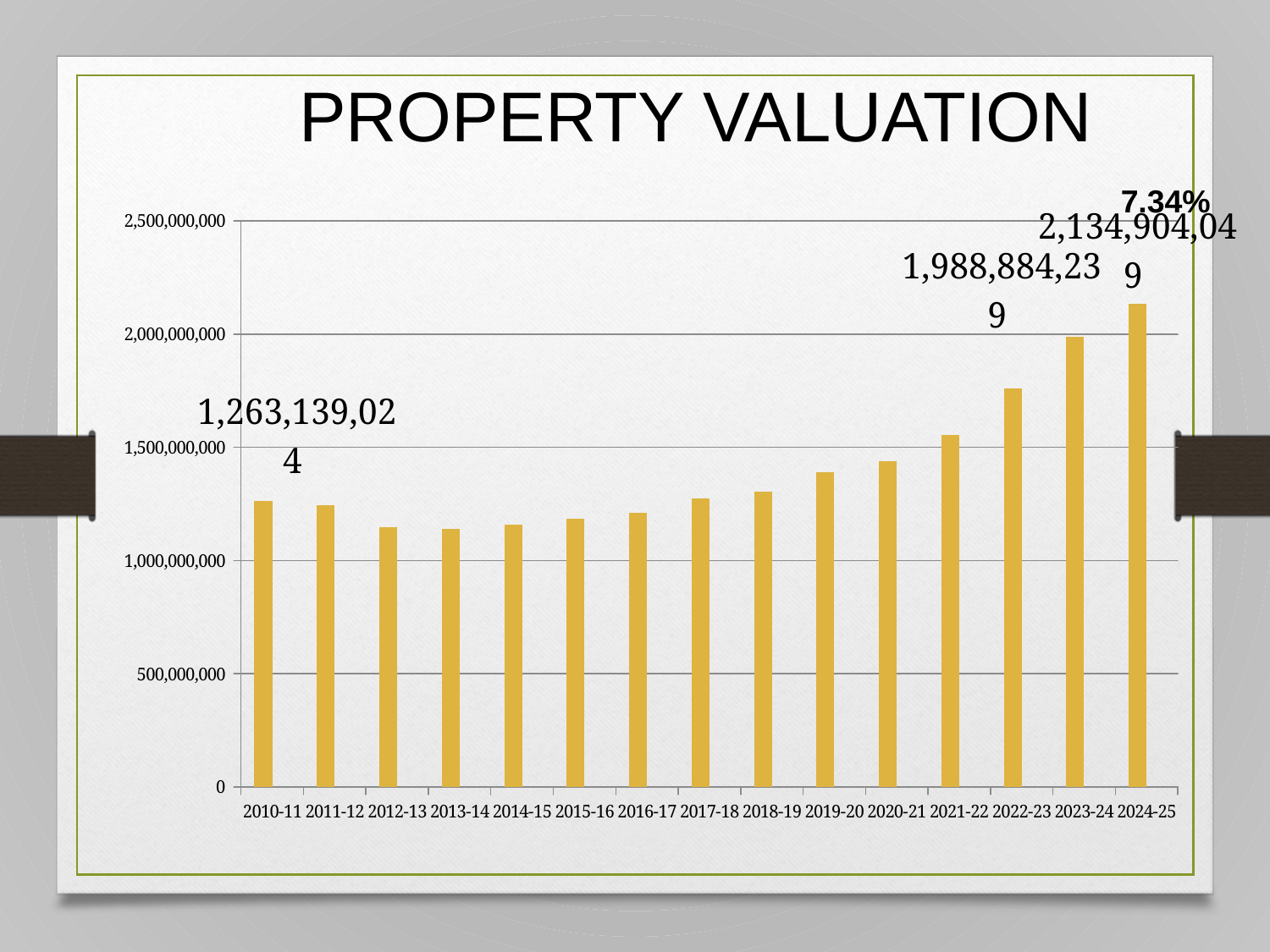
What is the property valuation for 2023-24? 1,988,884,239 What is the difference between the property valuation for 2024-25 and 2023-24? 146,019,810 How many years are shown on the x axis of the chart? 15 Is the value for 2022-23 greater or less than 1,500,000,000? greater Which is larger, the property valuation for 2010-11 or for 2023-24? 2023-24 What is the property valuation for 2024-25? 2,134,904,049 Which year has the highest property valuation? 2024-25 What kind of chart is shown on the slide? bar chart What is the property valuation for 2010-11? 1,263,139,024 What percentage is printed above the 2024-25 bar? 7.34% What is the title of the chart? PROPERTY VALUATION Which year has the lowest property valuation? 2013-14